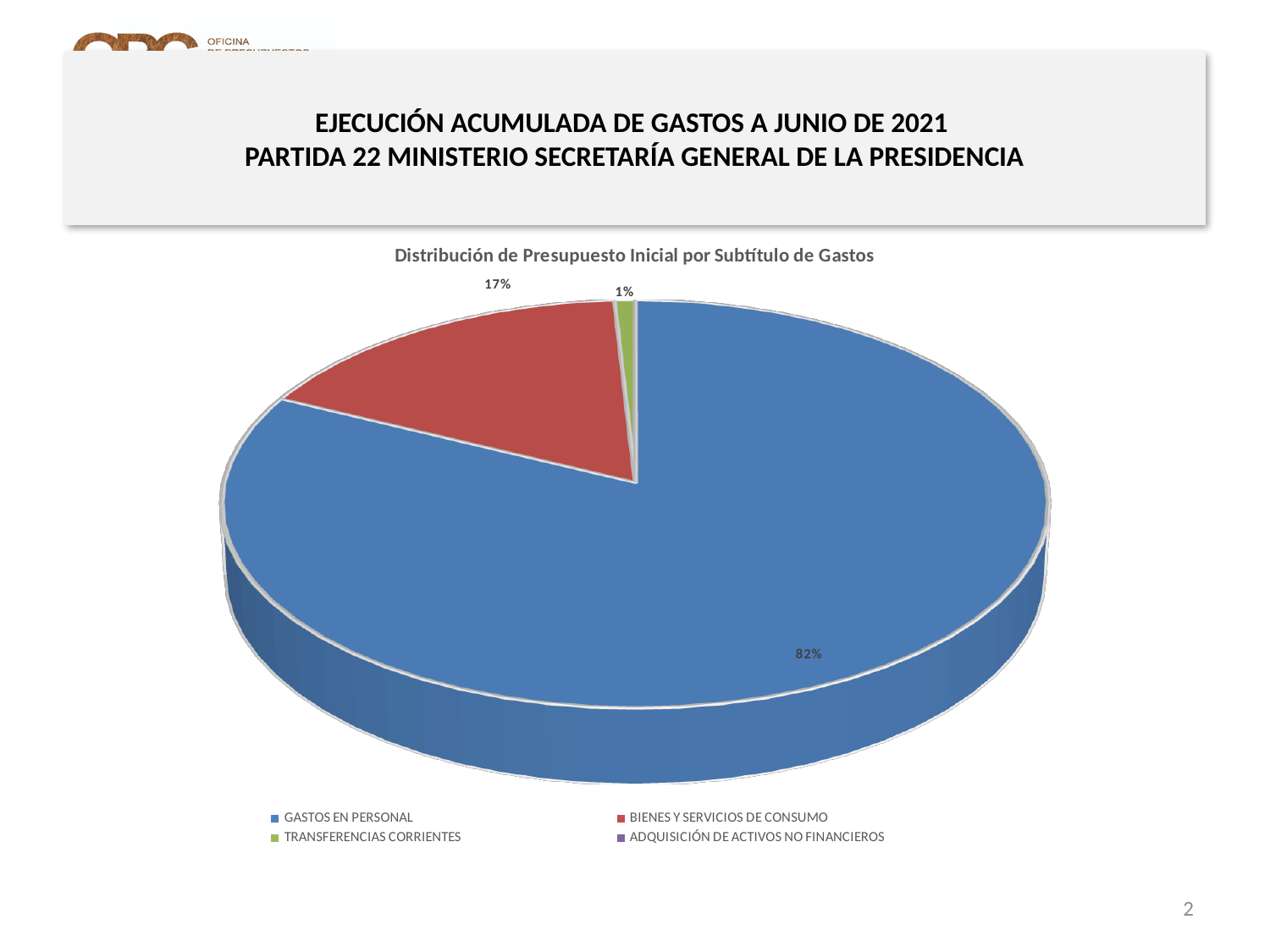
How many categories does the legend list? 4 What share of the pie does GASTOS EN PERSONAL represent? 82% Which is larger, the slice for BIENES Y SERVICIOS DE CONSUMO or the slice for TRANSFERENCIAS CORRIENTES? BIENES Y SERVICIOS DE CONSUMO What is the title of the chart? Distribución de Presupuesto Inicial por Subtítulo de Gastos Is the share for BIENES Y SERVICIOS DE CONSUMO greater or less than 50%? less What percentage is shown for TRANSFERENCIAS CORRIENTES? 1% Which category has the largest slice of the pie? GASTOS EN PERSONAL What is the difference in percentage points between GASTOS EN PERSONAL and BIENES Y SERVICIOS DE CONSUMO? 65 percentage points What percentage is shown for BIENES Y SERVICIOS DE CONSUMO? 17% What kind of chart is shown on the slide? Pie chart What colour is the slice for GASTOS EN PERSONAL? Blue